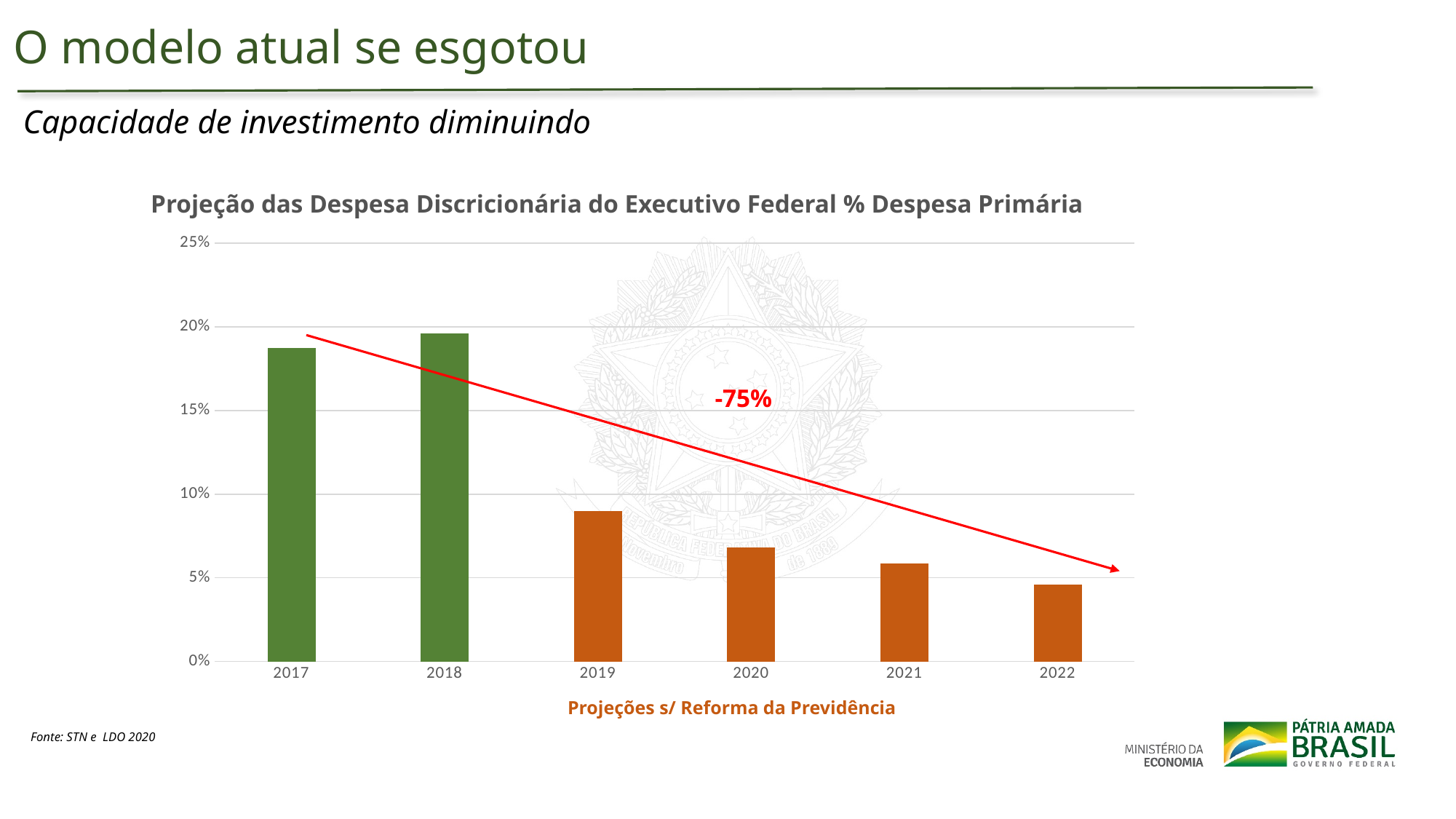
Do the values generally rise or fall from 2018 to 2022? Fall How many years are shown on the x axis of the chart? 6 What percentage change is written in red on the chart? -75% Is the value for 2017 greater or less than 15%? greater Is the value for 2022 greater or less than 10%? less Which is larger, the value for 2019 or the value for 2020? 2019 Is the value for 2020 greater or less than 5%? greater What kind of chart is shown on the slide? Bar chart Which year has the lowest value in the chart? 2022 What is the title of the chart? Projeção das Despesa Discricionária do Executivo Federal % Despesa Primária